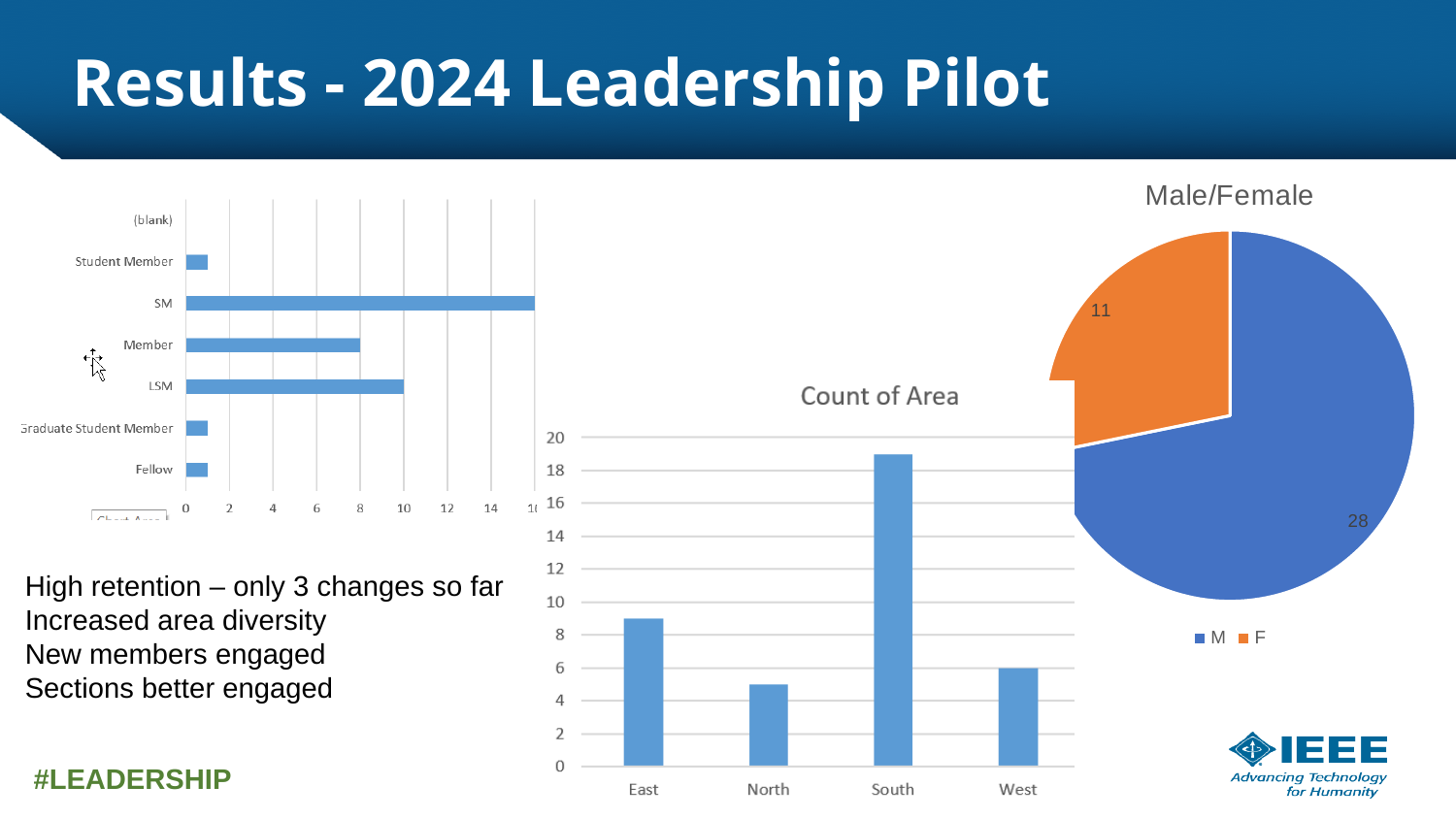
In the Male/Female pie chart, what is the difference between the M and F values? 17 In the Count of Area chart, what is the value for West? 6 In the Count of Area chart, is the value for East greater or less than 10? less In the horizontal bar chart on the left, what is the value for Member? 8 In the horizontal bar chart on the left, which category has the longest bar? SM What kind of chart is the Male/Female chart? Pie chart In the Male/Female pie chart, what is the value for M? 28 In the Count of Area chart, which area has the highest count? South In the Male/Female pie chart, what is the value for F? 11 In the Count of Area chart, is the value for South greater or less than 18? greater In the Count of Area chart, how many areas are shown on the x axis? 4 In the Count of Area chart, which area has the lowest count? North